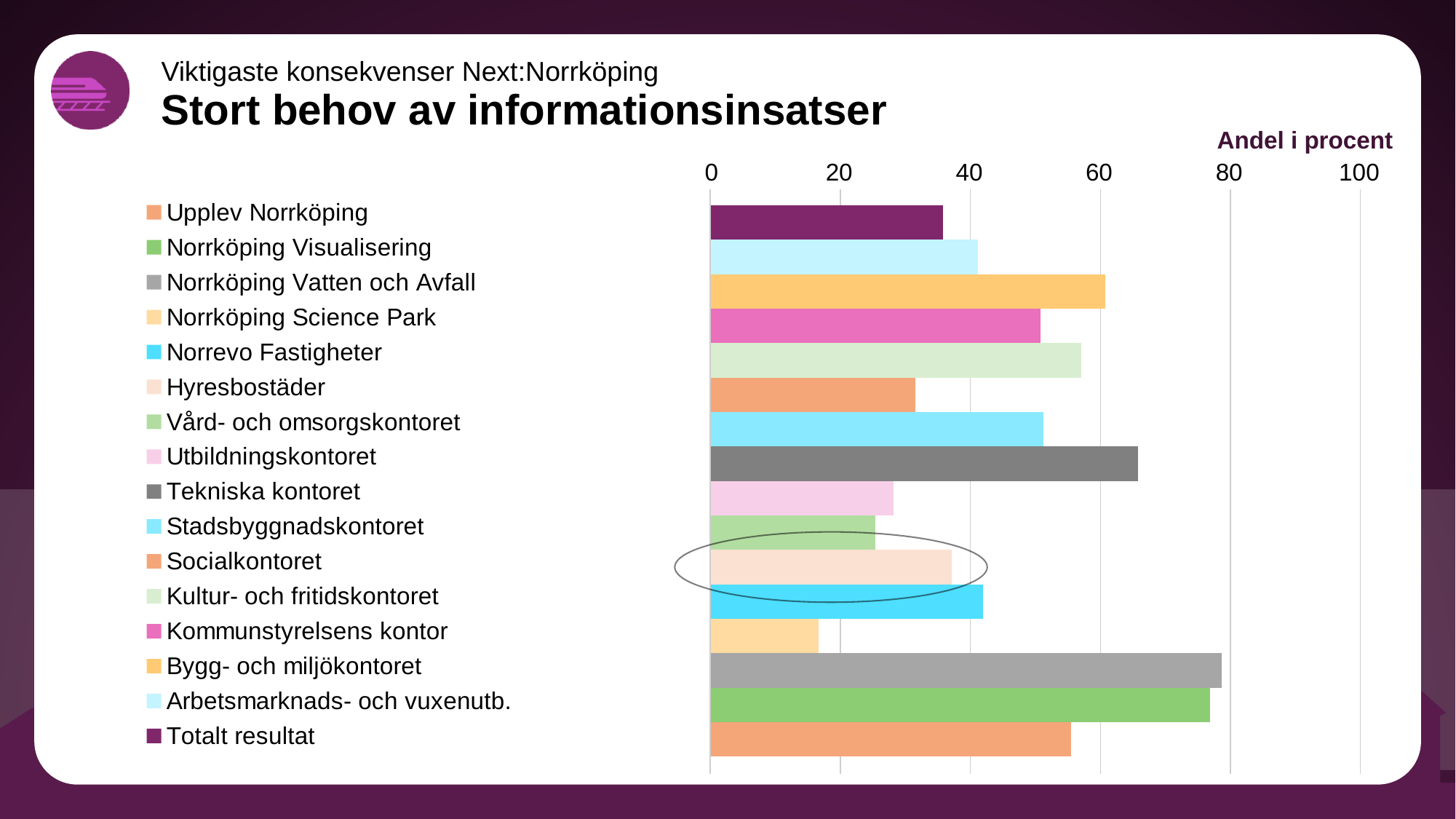
Which has a larger value, Tekniska kontoret or Socialkontoret? Tekniska kontoret What is the highest tick value shown on the horizontal axis? 100 Is the value for Kommunstyrelsens kontor greater or less than 40? greater Is the value for Tekniska kontoret greater or less than 60? greater Is the value for Socialkontoret greater or less than 40? less How many entries does the chart legend list? 16 Which category has the lowest value in the chart? Norrköping Science Park Which has a larger value, Kultur- och fritidskontoret or Utbildningskontoret? Kultur- och fritidskontoret What label is shown above the horizontal axis of the chart? Andel i procent What kind of chart is shown on the slide? bar chart